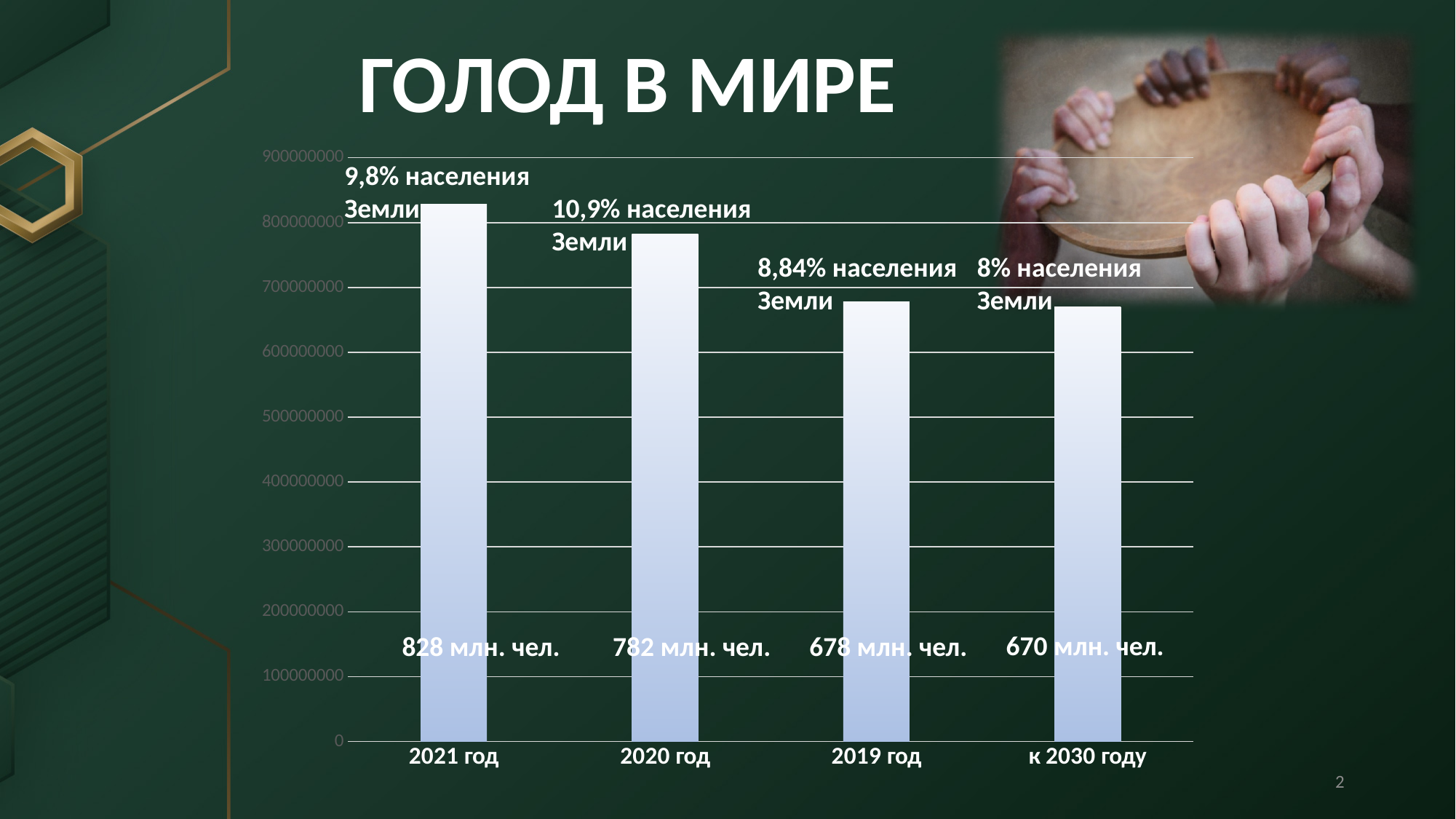
What is the value shown for к 2030 году? 670 млн. чел. What percentage of the Earth's population is shown above the bar for 2020 год? 10,9% населения Земли What is the difference between the values for 2021 год and 2020 год? 46 млн. чел. What type of chart is shown on the slide? bar chart What is the value shown for 2021 год? 828 млн. чел. How many bars (categories) does the chart show? 4 Which is larger, the value for 2020 год or the value for 2019 год? 2020 год Which category has the highest value? 2021 год What is the value shown for 2020 год? 782 млн. чел. What is the title of the slide containing the chart? ГОЛОД В МИРЕ Which category has the lowest value? к 2030 году What is the value shown for 2019 год? 678 млн. чел.